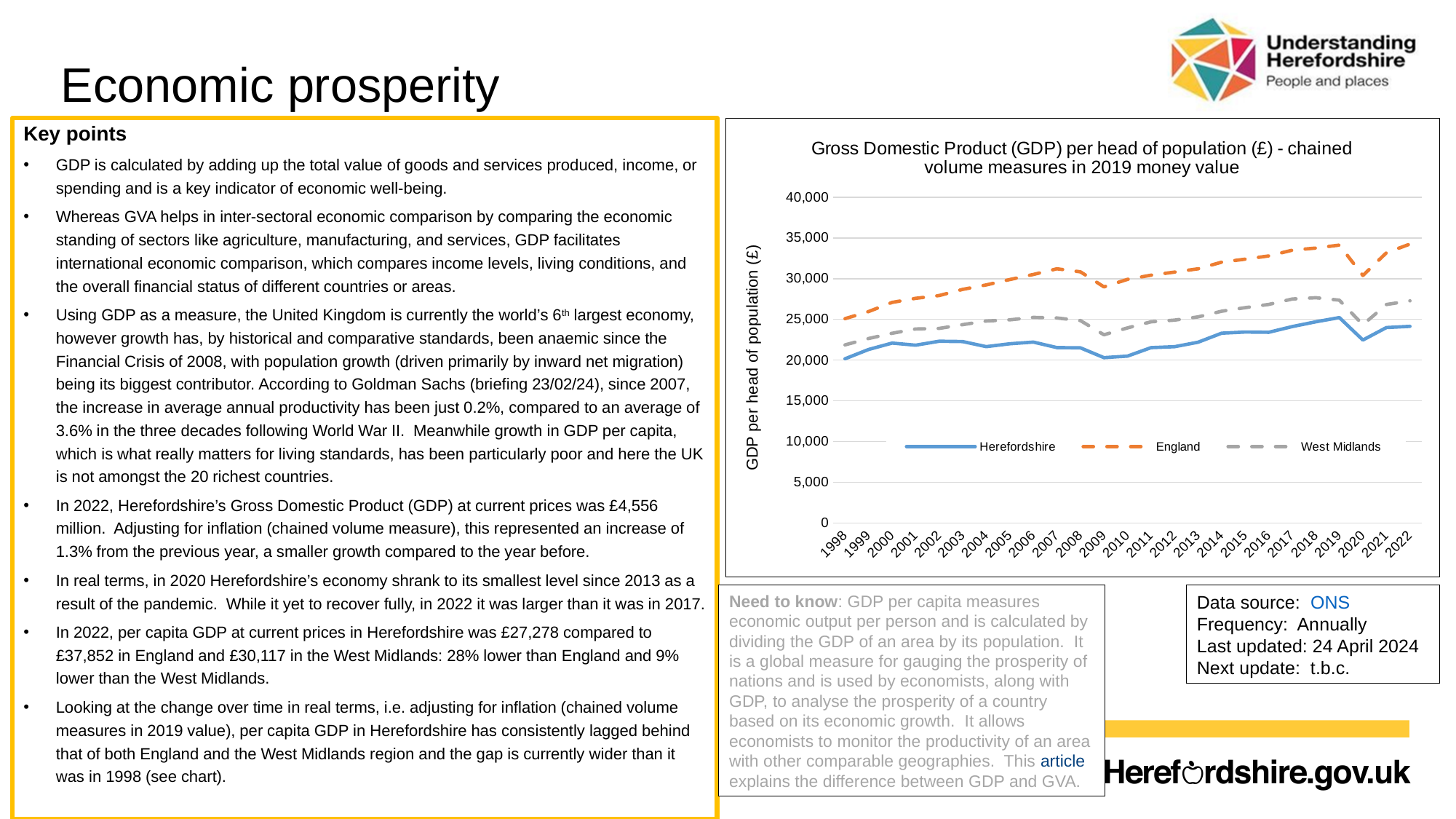
How many years are shown along the x axis of the chart? 25 Which series has the lowest GDP per head in 2022? Herefordshire Overall, does the England series rise or fall between 1998 and 2022? Rise What is the first year shown on the chart's x axis? 1998 Is the value for West Midlands in 2009 greater or less than 25,000? less Is the value for Herefordshire in 1998 greater or less than 25,000? less Is the value for England in 2022 greater or less than 30,000? greater What kind of chart is shown on the slide? Line chart Which series has the highest GDP per head in 2022? England Which areas are listed in the chart's legend? Herefordshire, England, West Midlands Which is larger in 2019, the value for England or the value for Herefordshire? England How many series does the chart's legend list? 3